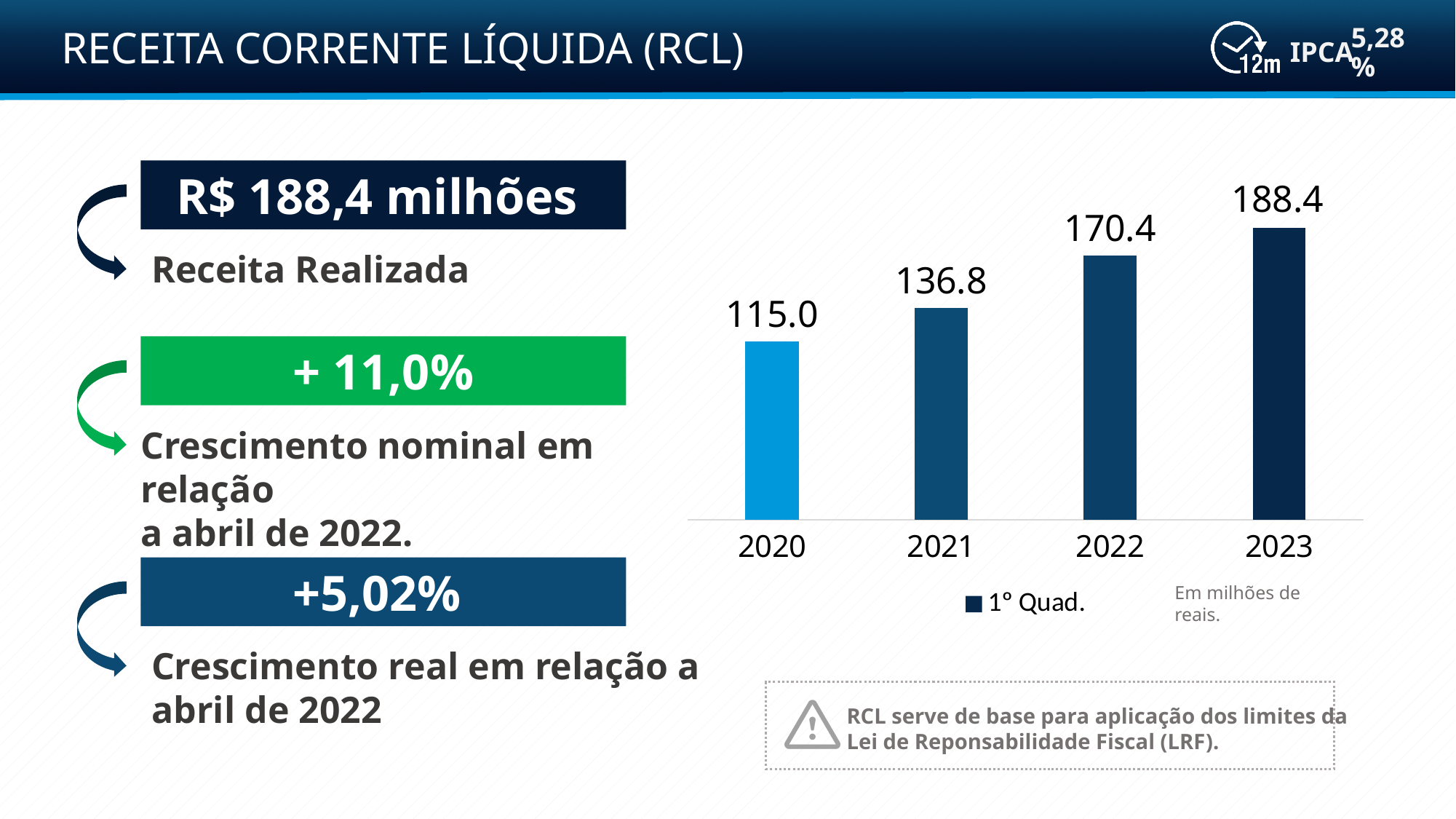
What is the value for 2022 in the chart? 170.4 What is the value for 2023 in the chart? 188.4 How many years are shown on the x axis of the chart? 4 What is the value for 2021 in the chart? 136.8 What kind of chart is shown on the slide? bar chart What is the value for 2020 in the chart? 115.0 What is the difference between the values for 2023 and 2022? 18.0 Which is larger, the value for 2021 or the value for 2022? 2022 Do the values rise or fall from 2020 to 2023? rise Which year has the highest value in the chart? 2023 Which year has the lowest value in the chart? 2020 What is the difference between the values for 2021 and 2020? 21.8